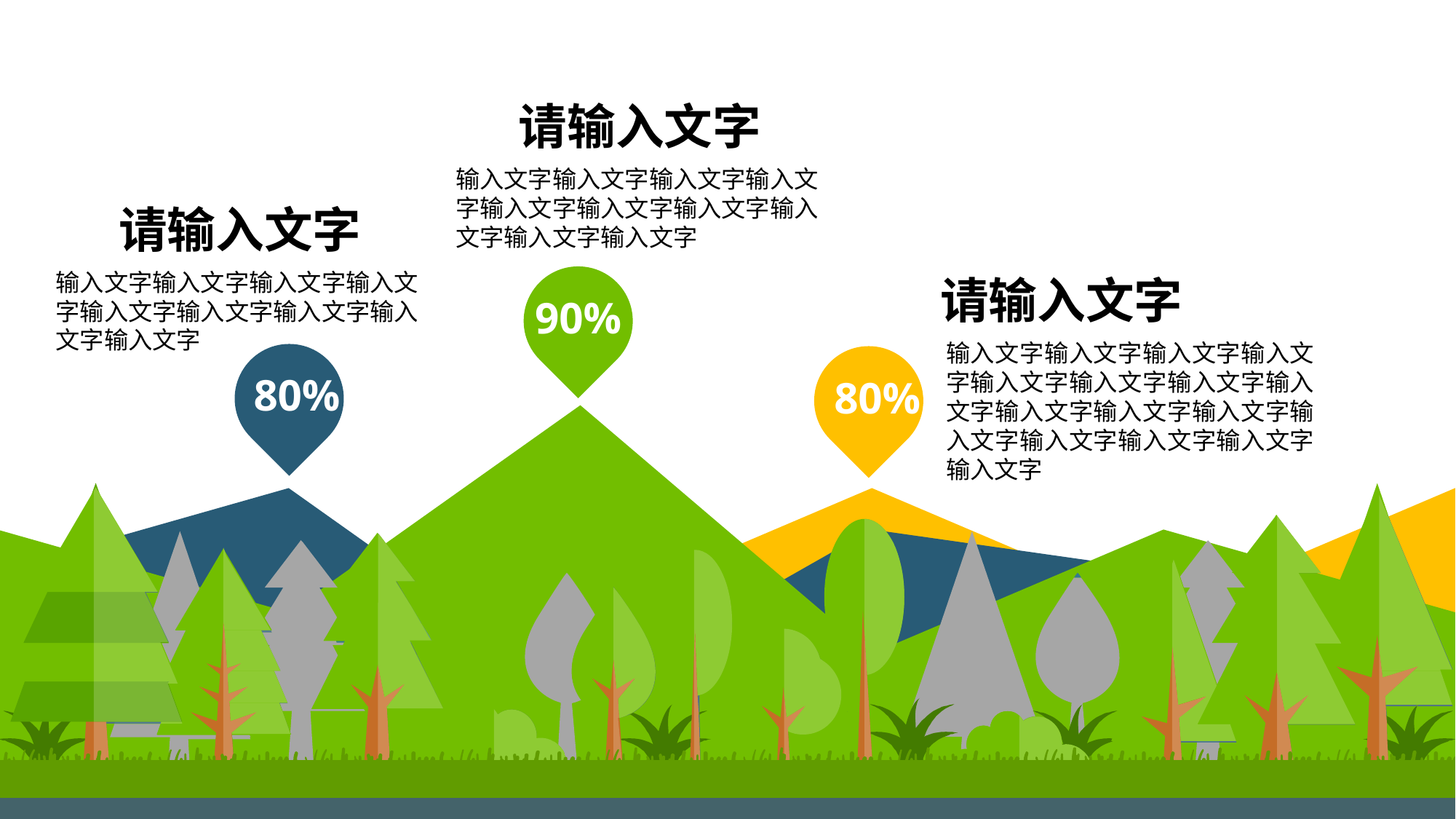
What colour is the marker on the right peak? yellow What percentage is shown in the green marker on the middle peak? 90% Which marker shows the highest percentage: the blue, green or yellow one? green How many percentage markers are shown on the slide? 3 What percentage is shown in the blue marker on the left peak? 80% What colour is the marker on the tallest (middle) peak? green Is the green marker's percentage larger than the yellow marker's percentage? Yes What percentage is shown in the yellow marker on the right peak? 80% Do the blue and yellow markers show the same percentage? Yes What is the difference between the green marker's percentage and the blue marker's percentage? 10%